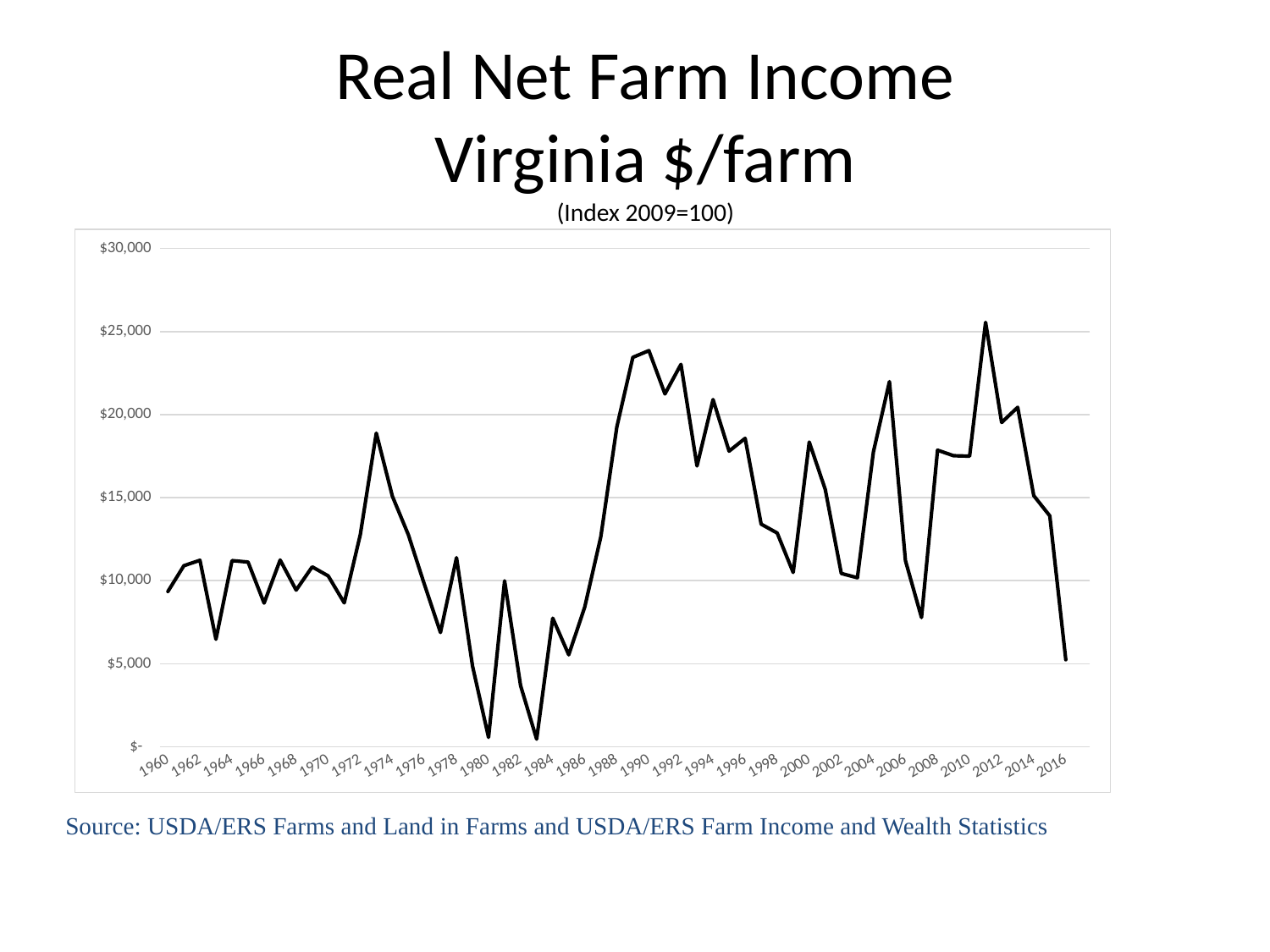
Is the value for 1980 greater or less than $5,000? less Is the value for 1960 greater or less than $10,000? less What is the title of the chart on the slide? Real Net Farm Income Virginia $/farm What kind of chart is shown on the slide? line chart Is the value for 1990 greater or less than $20,000? greater In which year does real net farm income reach its highest point? 2011 Which year has the larger value, 1973 or 1990? 1990 Do the values rise or fall from 2011 to 2016? fall What index base year is stated under the chart title? 2009=100